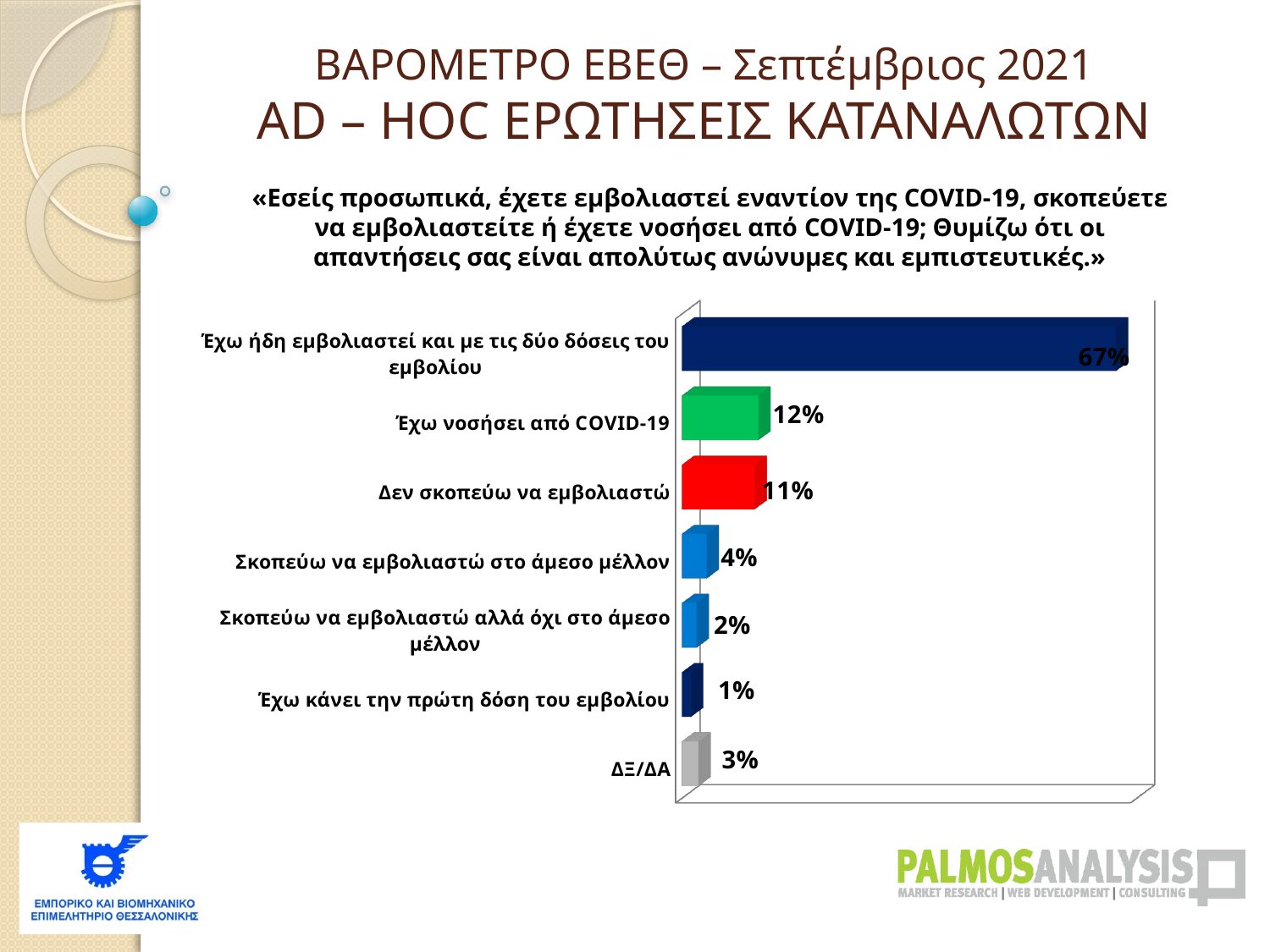
What percentage of respondents said they have already been vaccinated with both doses (Έχω ήδη εμβολιαστεί και με τις δύο δόσεις του εμβολίου)? 67% Which category has the lowest value? Έχω κάνει την πρώτη δόση του εμβολίου What is the difference between 'Έχω νοσήσει από COVID-19' and 'Δεν σκοπεύω να εμβολιαστώ'? 1% What is the value for 'Δεν σκοπεύω να εμβολιαστώ'? 11% Which category has the highest value? Έχω ήδη εμβολιαστεί και με τις δύο δόσεις του εμβολίου How many categories are shown in the chart? 7 Which is larger: 'Σκοπεύω να εμβολιαστώ στο άμεσο μέλλον' or 'Σκοπεύω να εμβολιαστώ αλλά όχι στο άμεσο μέλλον'? Σκοπεύω να εμβολιαστώ στο άμεσο μέλλον What is the difference between the highest value and the value for 'ΔΞ/ΔΑ'? 64% What is the value for 'Έχω νοσήσει από COVID-19'? 12% What is the value for 'ΔΞ/ΔΑ'? 3% What kind of chart is shown on the slide? Bar chart What is the value for 'Σκοπεύω να εμβολιαστώ στο άμεσο μέλλον'? 4%